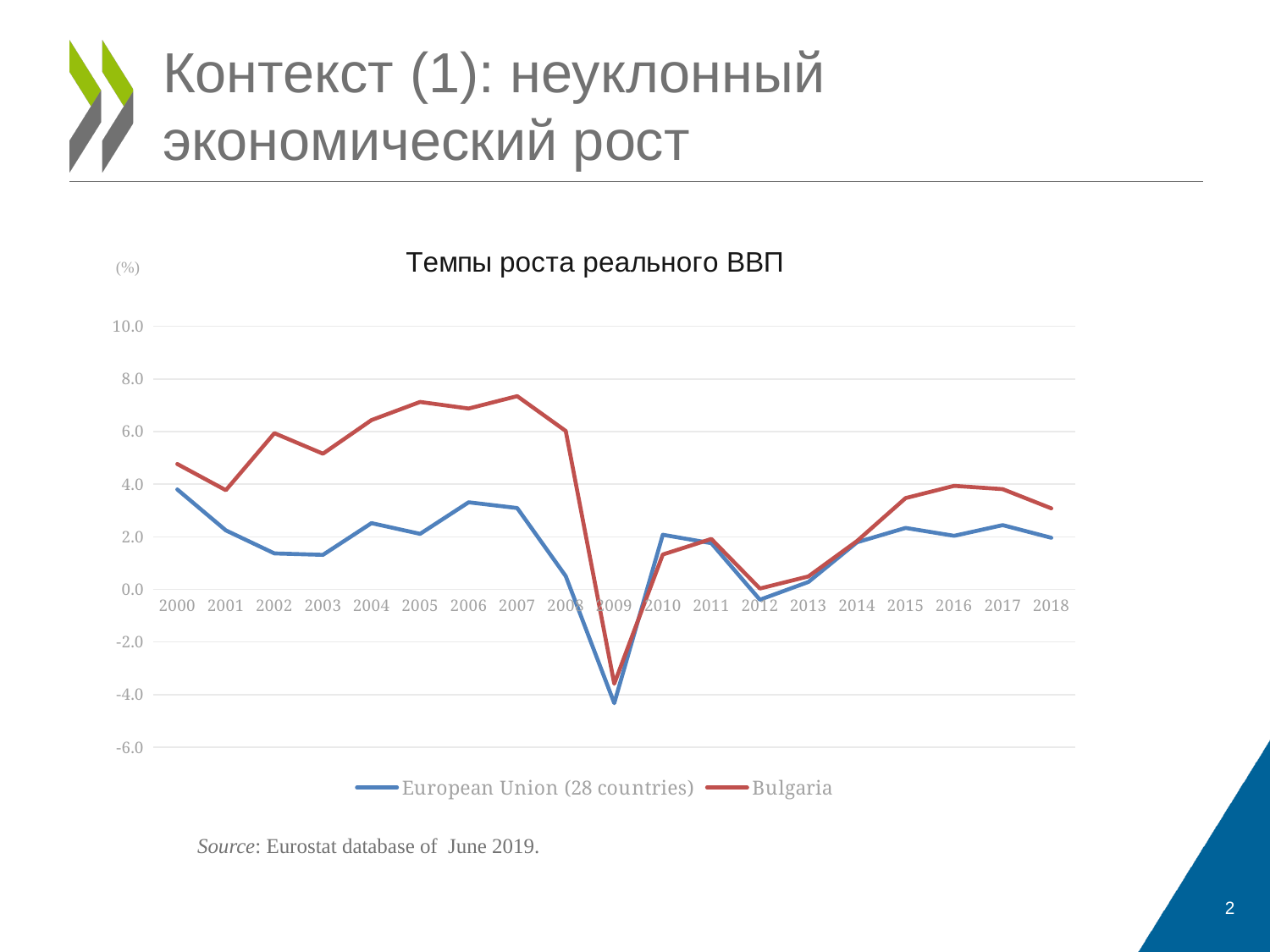
How many series does the legend of the chart list? 2 Is the value for Bulgaria in 2009 greater or less than -2.0? less Which series is drawn in red in the chart? Bulgaria In 2005, which series has the higher value, Bulgaria or European Union (28 countries)? Bulgaria In which year does the Bulgaria series reach its highest value? 2007 What is the title of the chart? Темпы роста реального ВВП Is the value for European Union (28 countries) in 2003 greater or less than 2.0? less What kind of chart is shown on the slide? Line chart Does the Bulgaria series rise or fall between 2009 and 2016? Rise How many years are plotted along the x axis of the chart? 19 In which year does the European Union (28 countries) series reach its lowest value? 2009 Is the value for Bulgaria in 2007 greater or less than 6.0? greater